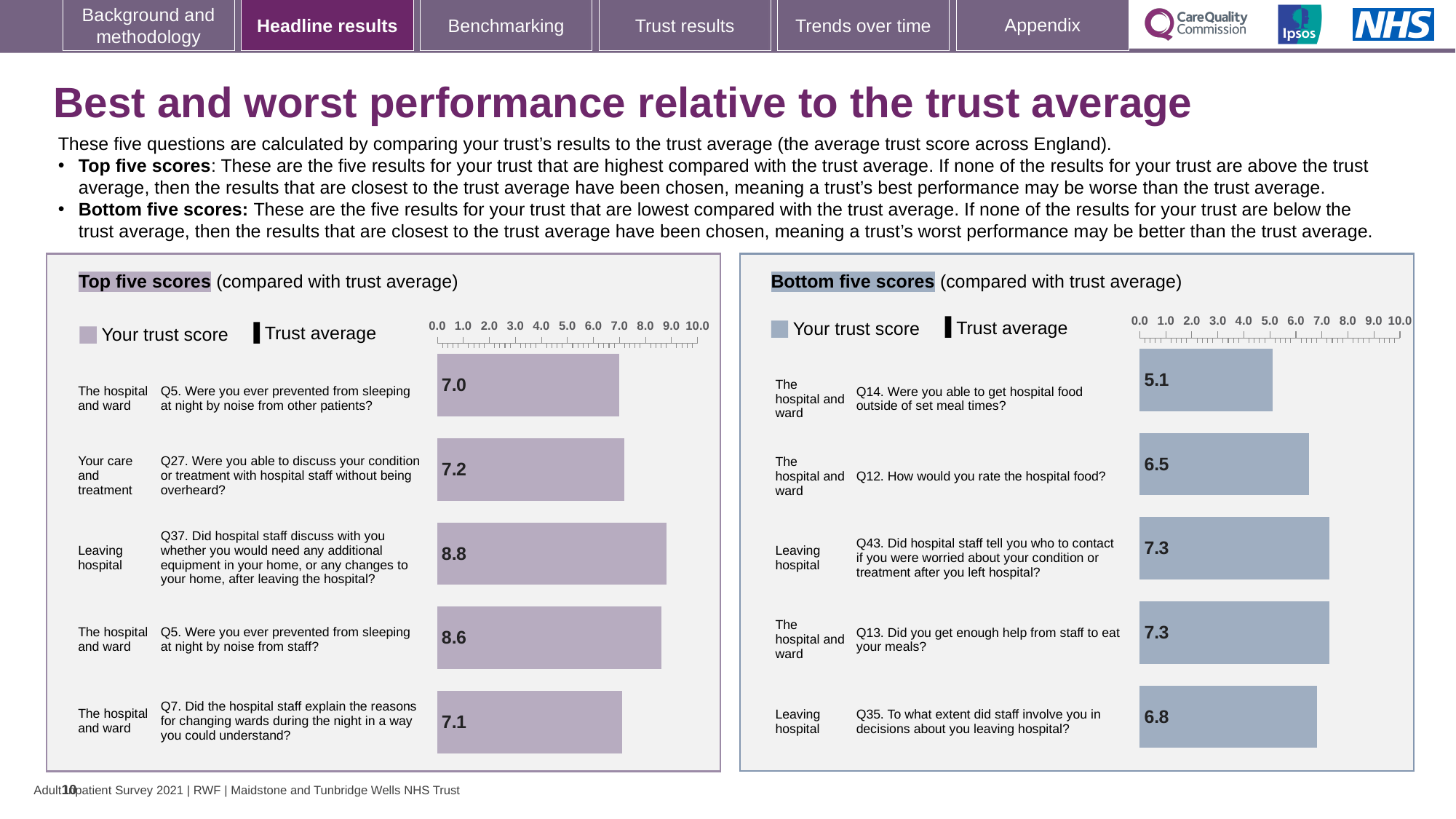
In the Top five scores chart, what is the trust score for Q37 about hospital staff discussing additional equipment or changes to your home after leaving hospital? 8.8 In the Top five scores chart, what is the trust score for Q27 about discussing your condition or treatment without being overheard? 7.2 In the Bottom five scores chart, which question has the lowest trust score? Q14. Were you able to get hospital food outside of set meal times? In the Bottom five scores chart, what is the trust score for Q35 about staff involving you in decisions about leaving hospital? 6.8 In the Top five scores chart, which has the higher score: Q5 about noise from staff or Q7 about explaining reasons for changing wards? Q5 about noise from staff In the Top five scores chart, which question has the highest trust score? Q37. Did hospital staff discuss with you whether you would need any additional equipment in your home, or any changes to your home, after leaving the hospital? In the Bottom five scores chart, what is the difference between the score for Q12 (6.5) and the score for Q14 (5.1)? 1.4 In the Top five scores chart, what is the difference between the score for Q37 (8.8) and the score for Q5 about noise from other patients (7.0)? 1.8 How many series does the legend of the Top five scores chart list? 2 What kind of chart is used in the Bottom five scores panel? Bar chart How many questions are shown in the Bottom five scores chart? 5 In the Bottom five scores chart, what is the trust score for Q14 about getting hospital food outside of set meal times? 5.1